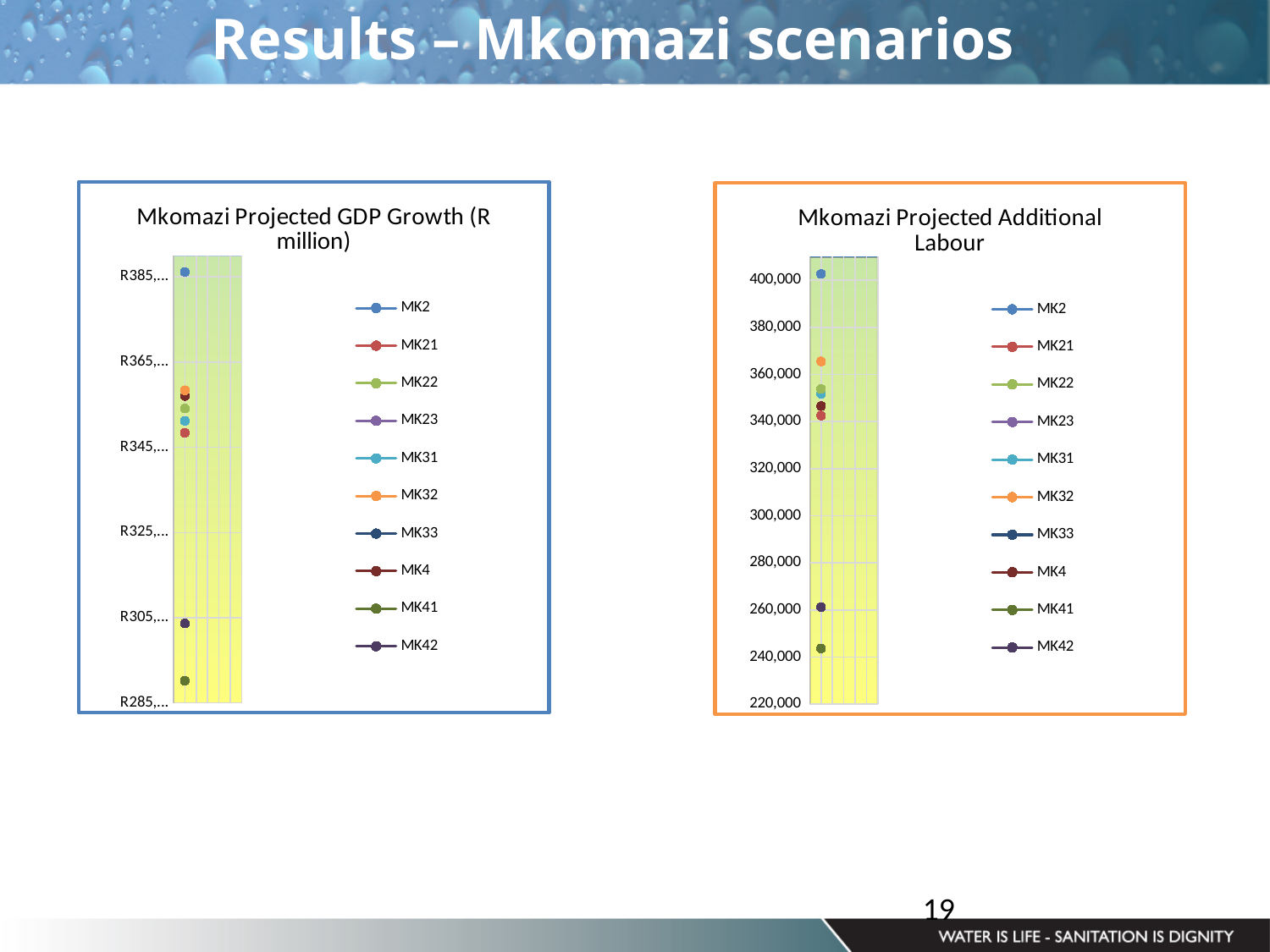
On the Mkomazi Projected Additional Labour chart, which scenario has the highest value? MK2 On the Mkomazi Projected GDP Growth (R million) chart, which scenario has the lowest value? MK41 On the Mkomazi Projected Additional Labour chart, which scenario has the lowest value? MK41 On the Mkomazi Projected Additional Labour chart, is the value for MK42 greater or less than 280,000? less On the Mkomazi Projected GDP Growth (R million) chart, how many series does the legend list? 10 On the Mkomazi Projected Additional Labour chart, is the value for MK32 greater or less than 360,000? greater On the Mkomazi Projected Additional Labour chart, how many series does the legend list? 10 On the Mkomazi Projected Additional Labour chart, is the value for MK2 greater or less than 380,000? greater On the Mkomazi Projected Additional Labour chart, which is larger, the value for MK2 or the value for MK42? MK2 What kind of chart is the Mkomazi Projected Additional Labour chart? Line chart with markers On the Mkomazi Projected GDP Growth (R million) chart, which scenario has the highest value? MK2